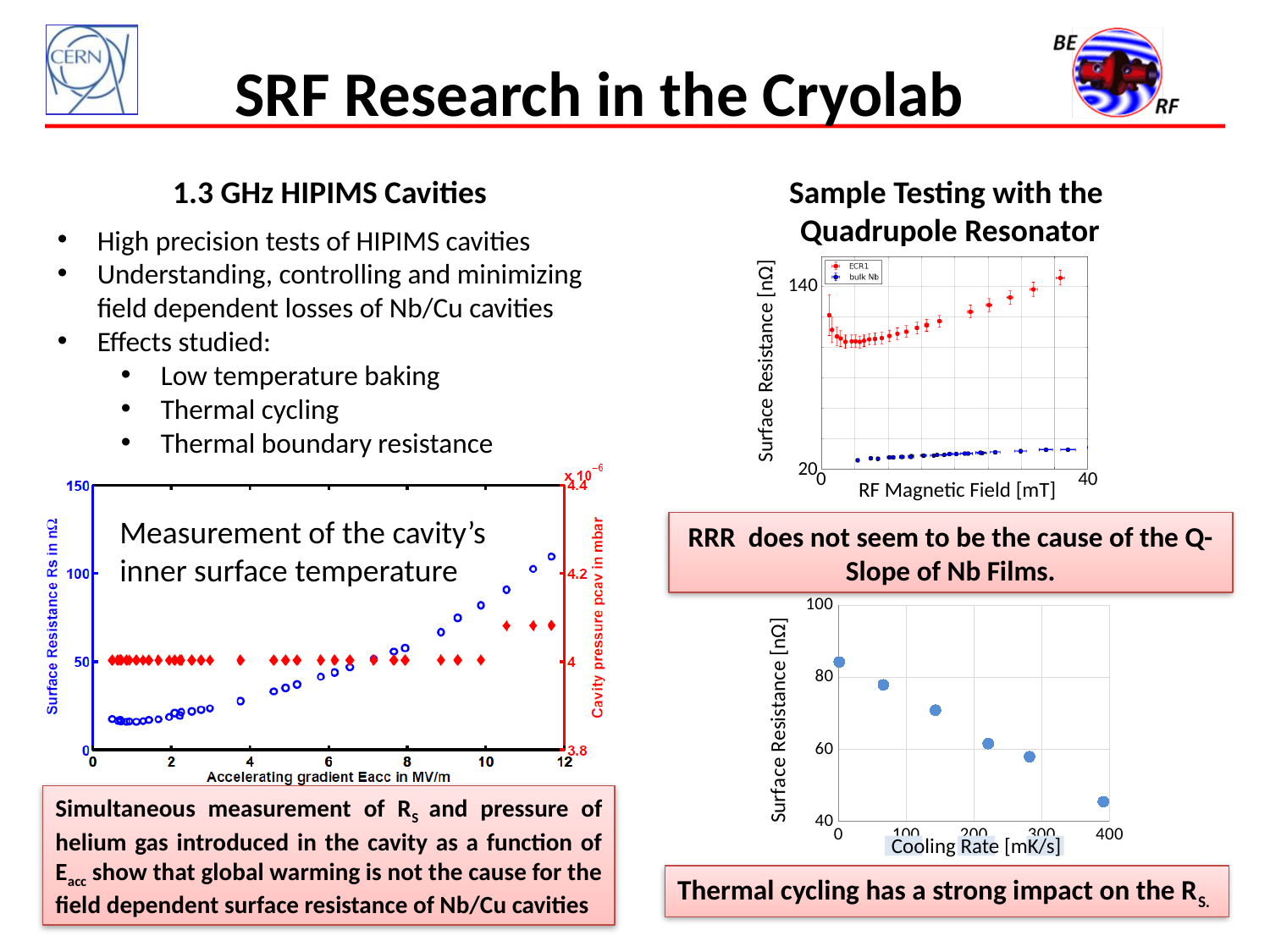
In the bottom-right chart of Surface Resistance versus Cooling Rate, do the values rise or fall as the cooling rate increases? fall In the bottom-right chart, what is the label of the x axis? Cooling Rate [mK/s] In the bottom-right chart of Surface Resistance versus Cooling Rate, how many data points are plotted? 6 In the top-right chart of Surface Resistance versus RF Magnetic Field, what is the label of the y axis? Surface Resistance [nΩ] In the top-right chart of Surface Resistance versus RF Magnetic Field, does the ECR1 surface resistance rise or fall as the field increases from 20 mT to 40 mT? rise In the top-right chart of Surface Resistance versus RF Magnetic Field, how many series does the legend list? 2 In the bottom-left chart of Surface Resistance Rs versus Accelerating gradient Eacc, do the blue surface resistance values rise or fall as Eacc increases? rise In the bottom-right chart of Surface Resistance versus Cooling Rate, is the surface resistance at the lowest cooling rate greater or less than 80? greater In the top-right chart of Surface Resistance versus RF Magnetic Field, which series has the higher surface resistance, ECR1 or bulk Nb? ECR1 In the bottom-right chart of Surface Resistance versus Cooling Rate, is the surface resistance at the highest cooling rate (near 400 mK/s) greater or less than 60? less In the bottom-left chart of Surface Resistance Rs versus Accelerating gradient Eacc, is the surface resistance at the highest Eacc (near 12 MV/m) greater or less than 100? greater